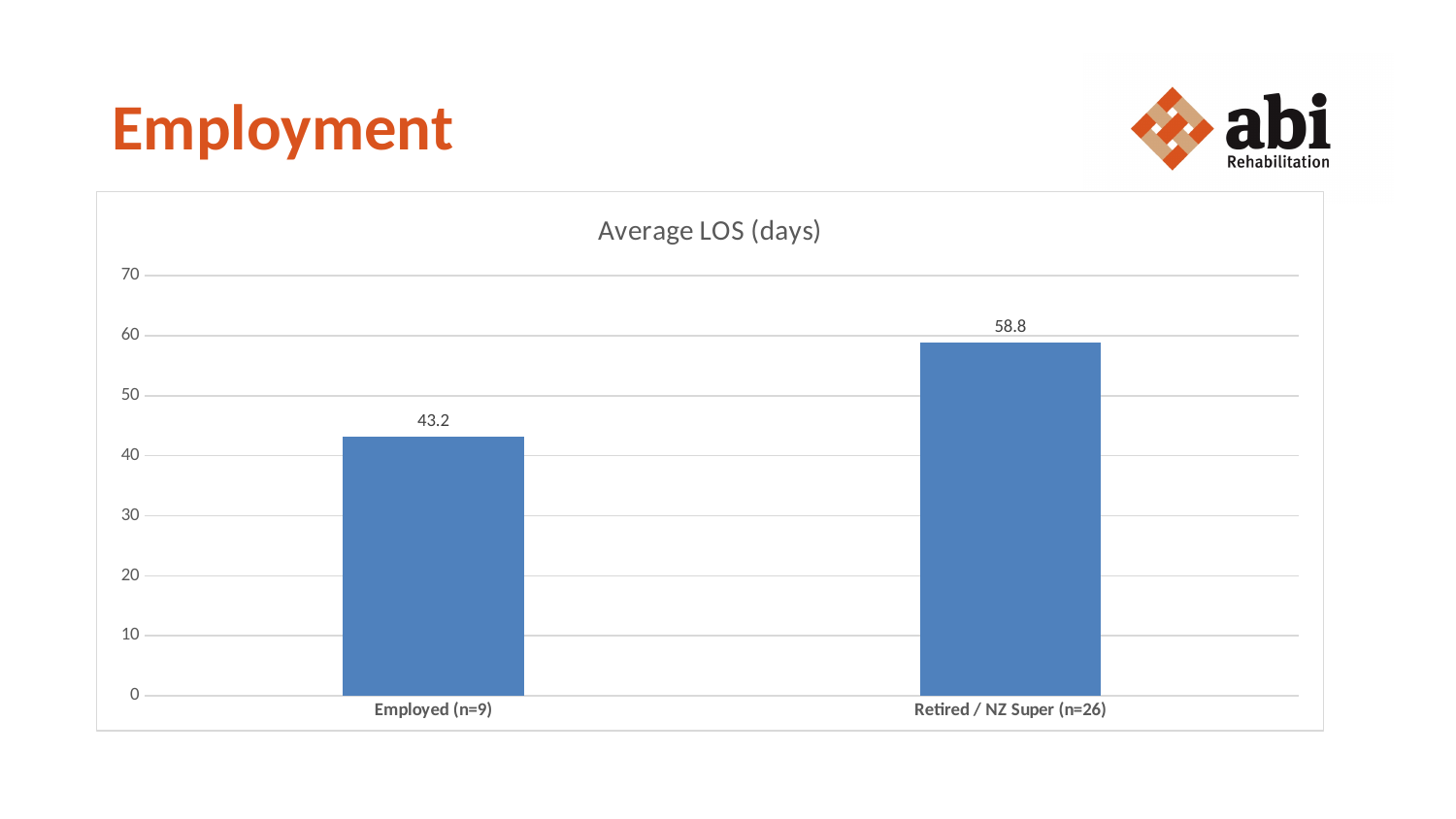
How many categories are shown on the chart? 2 What is the average LOS (days) for Retired / NZ Super (n=26)? 58.8 Is the average LOS for Retired / NZ Super (n=26) greater or less than 50? greater Which category has the lowest average LOS? Employed (n=9) What kind of chart is shown on the slide? Bar chart Which category has the highest average LOS? Retired / NZ Super (n=26) Which has a larger average LOS, Employed (n=9) or Retired / NZ Super (n=26)? Retired / NZ Super (n=26) What is the title of the chart? Average LOS (days) Is the average LOS for Employed (n=9) greater or less than 50? less What is the maximum value shown on the vertical axis? 70 What is the average LOS (days) for Employed (n=9)? 43.2 What is the difference in average LOS between Retired / NZ Super (n=26) and Employed (n=9)? 15.6